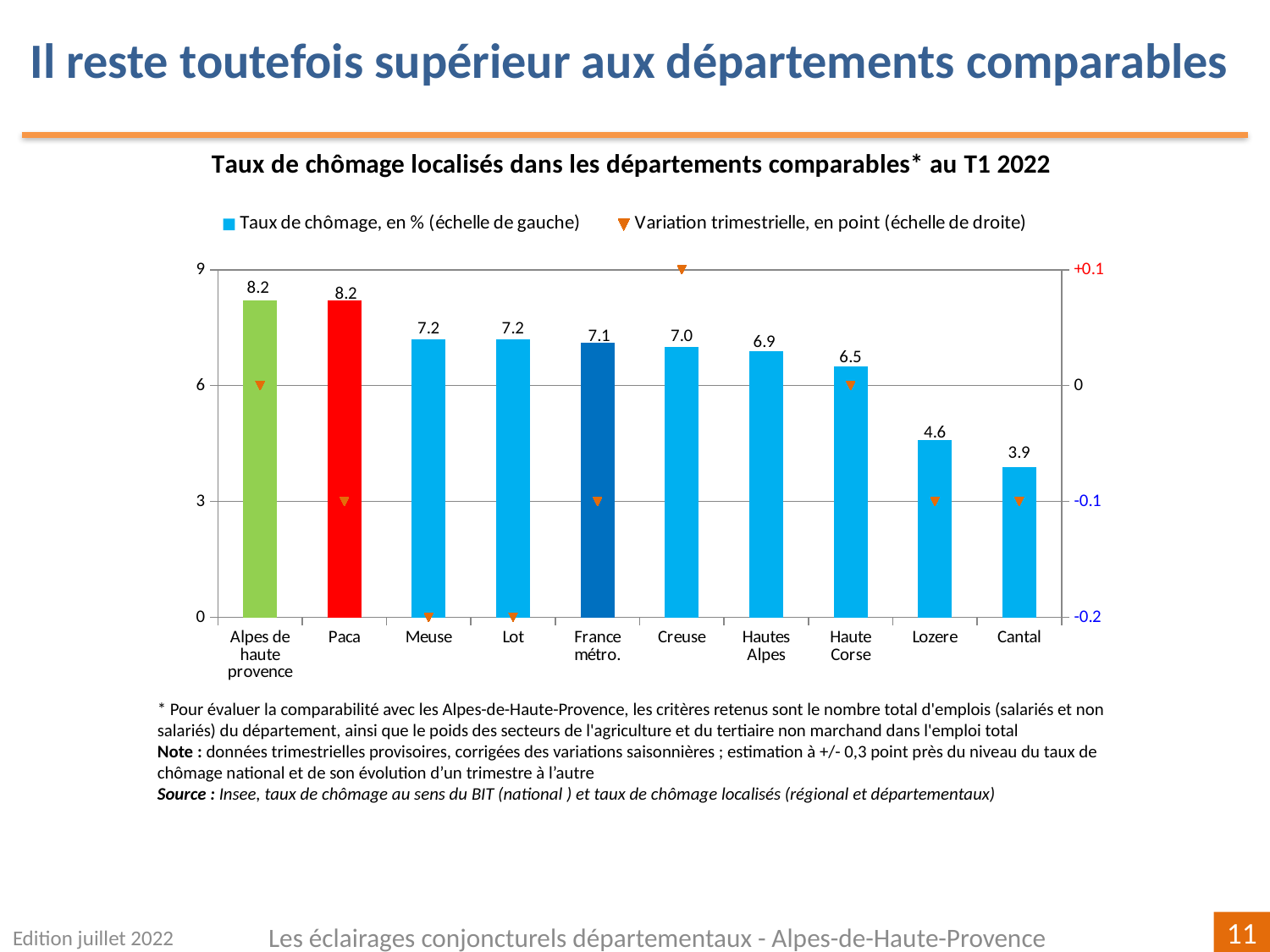
Which has a higher unemployment rate, Meuse or Creuse? Meuse Which category has the lowest unemployment rate? Cantal What is the unemployment rate (Taux de chômage) shown for Haute Corse? 6.5 What is the unemployment rate shown for France métro.? 7.1 What is the unemployment rate shown for Hautes Alpes? 6.9 What is the difference between the unemployment rate of Alpes de haute provence and that of Cantal? 4.3 What kind of chart is used to show the unemployment rates? bar chart What is the quarterly variation (Variation trimestrielle) shown for Creuse on the right-hand scale? +0.1 How many categories (départements/areas) are shown on the x axis? 10 Is the unemployment rate for Lozere greater or less than 6? less How many series does the legend list? 2 Do the unemployment rate bars rise or fall from left to right along the x axis? fall